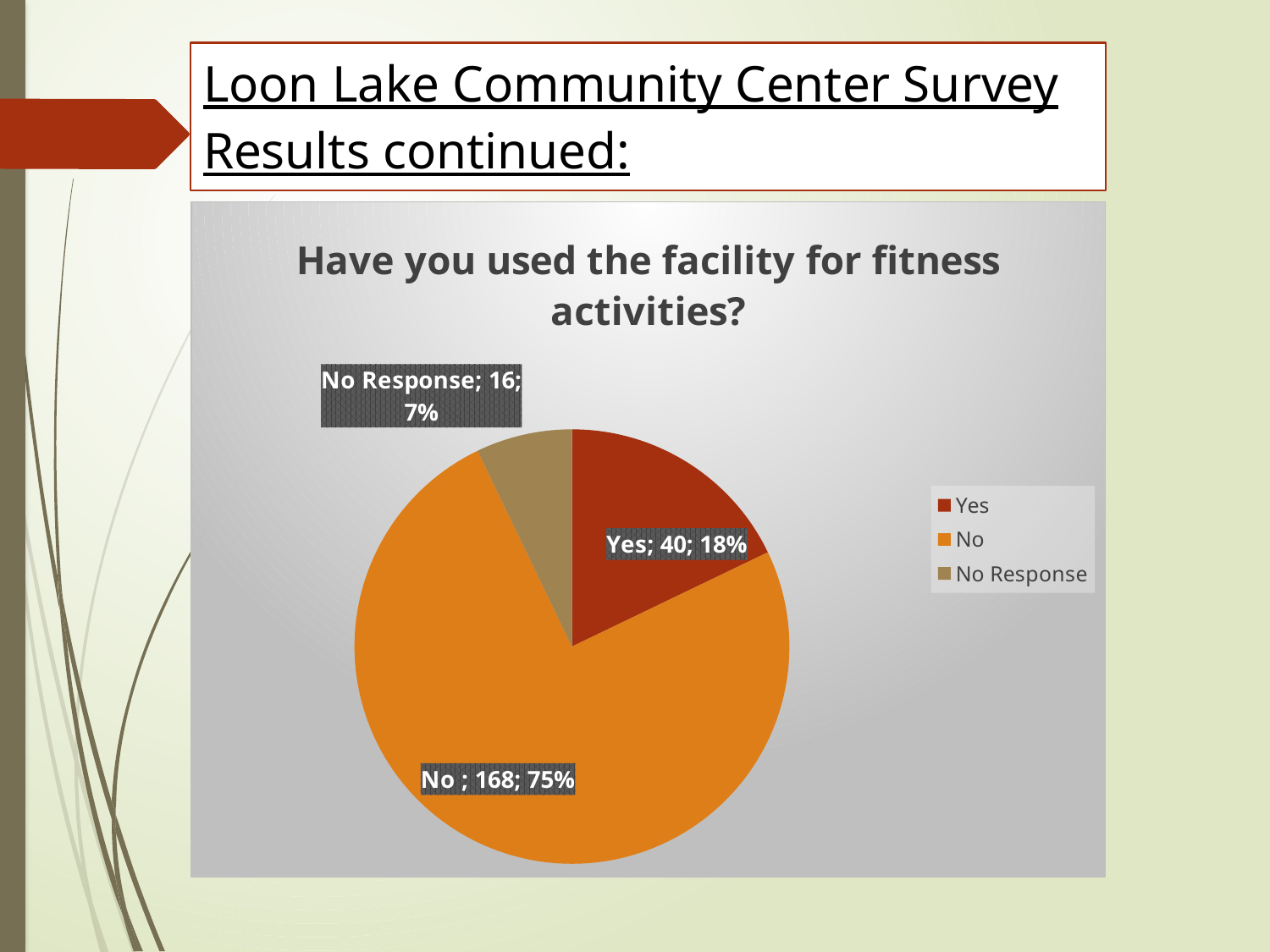
What is the title of the chart? Have you used the facility for fitness activities? What is the difference between the number of "No" and "Yes" responses? 128 Which category has the smallest slice? No Response Which category has the largest slice? No What share of the pie does the "Yes" slice represent? 18% How many respondents answered "Yes"? 40 How many respondents answered "No"? 168 How many respondents gave no response? 16 How many categories does the legend list? 3 What share of the pie does the "No Response" slice represent? 7% What kind of chart is shown on the slide? pie chart Which is larger, the "Yes" count or the "No Response" count? Yes